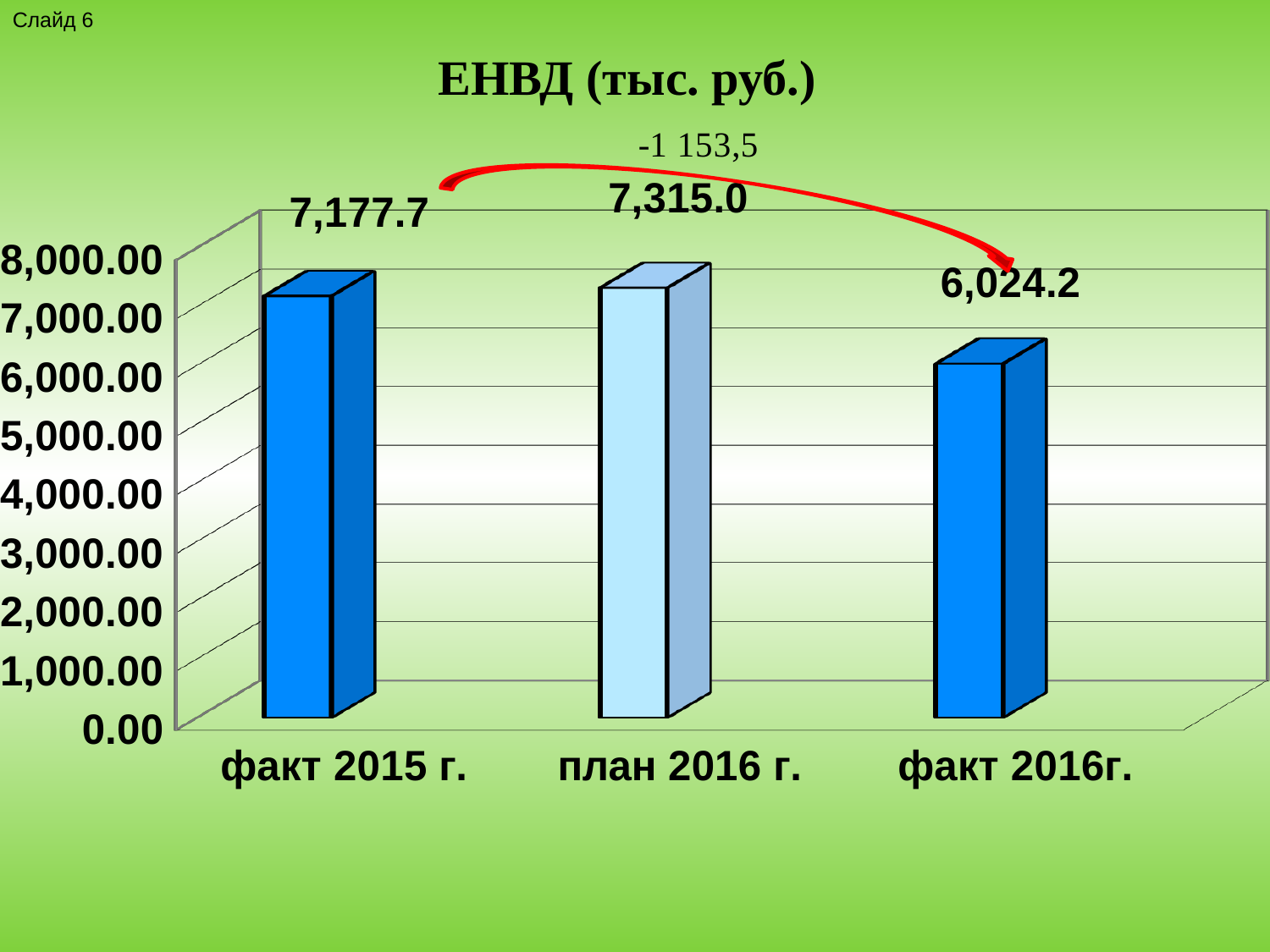
Which is larger, факт 2015 г. or факт 2016г.? факт 2015 г. What is the value for факт 2015 г.? 7,177.7 What kind of chart is shown on the slide? bar chart How many categories are shown on the chart? 3 What is the difference between план 2016 г. and факт 2016г.? 1,290.8 Which category has the highest value? план 2016 г. Which category has the lowest value? факт 2016г. What is the value for факт 2016г.? 6,024.2 What is the difference between факт 2015 г. and факт 2016г.? 1,153.5 Is the value for факт 2016г. greater or less than 7,000.00? less What is the title of the chart? ЕНВД (тыс. руб.) What is the value for план 2016 г.? 7,315.0